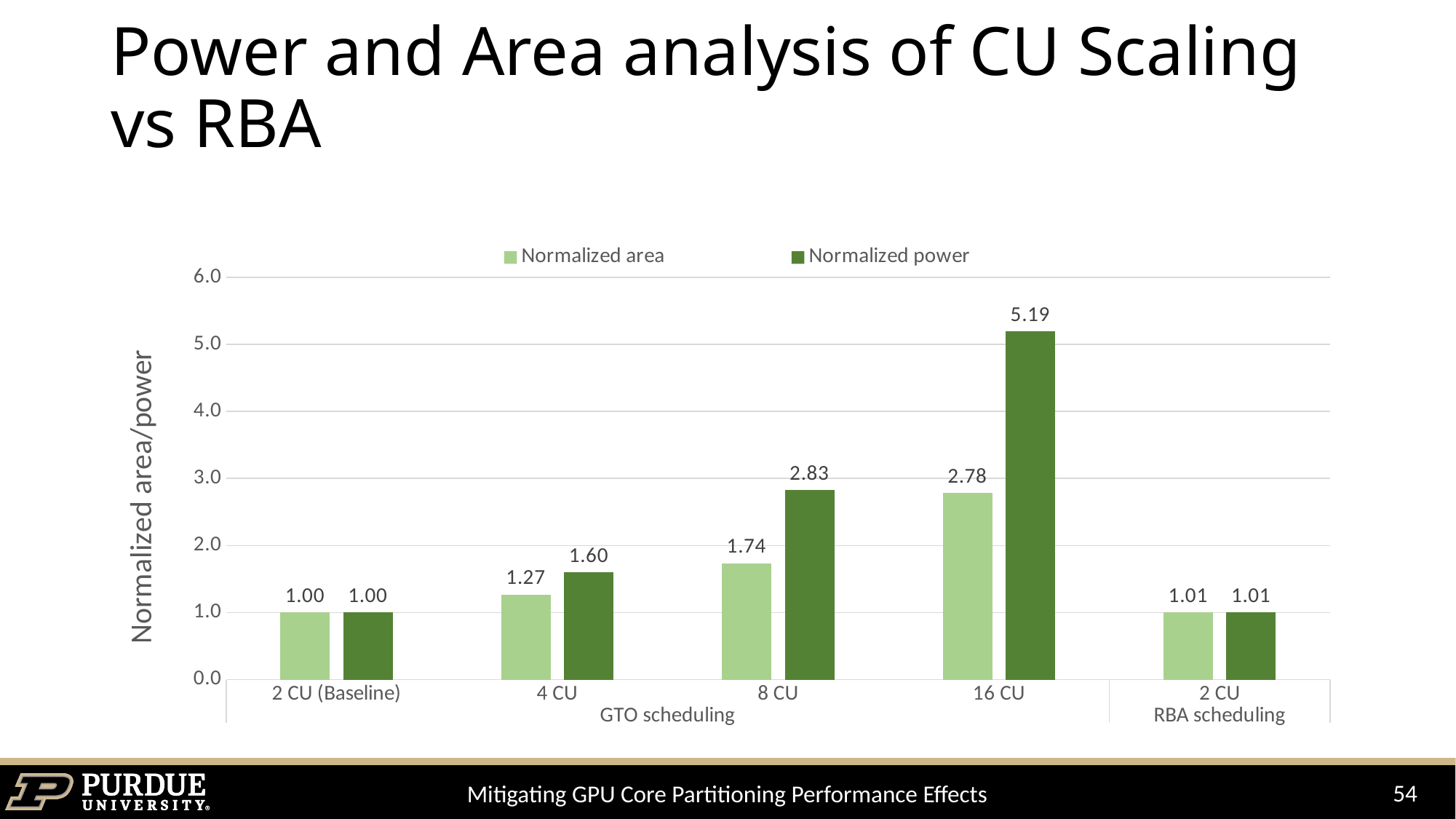
What is the Normalized area value for 8 CU under GTO scheduling? 1.74 What is the Normalized power value for 16 CU under GTO scheduling? 5.19 Which is larger for 8 CU: Normalized area or Normalized power? Normalized power How many categories are shown on the x axis? 5 What kind of chart is shown on the slide? Bar chart How many series does the legend list? 2 Which category has the highest Normalized power value? 16 CU What is the difference between the Normalized power and Normalized area values for 16 CU? 2.41 Which category has the lowest Normalized area value? 2 CU (Baseline) What is the Normalized area value for 2 CU under RBA scheduling? 1.01 What is the y-axis label of the chart? Normalized area/power What is the Normalized power value for 4 CU under GTO scheduling? 1.60